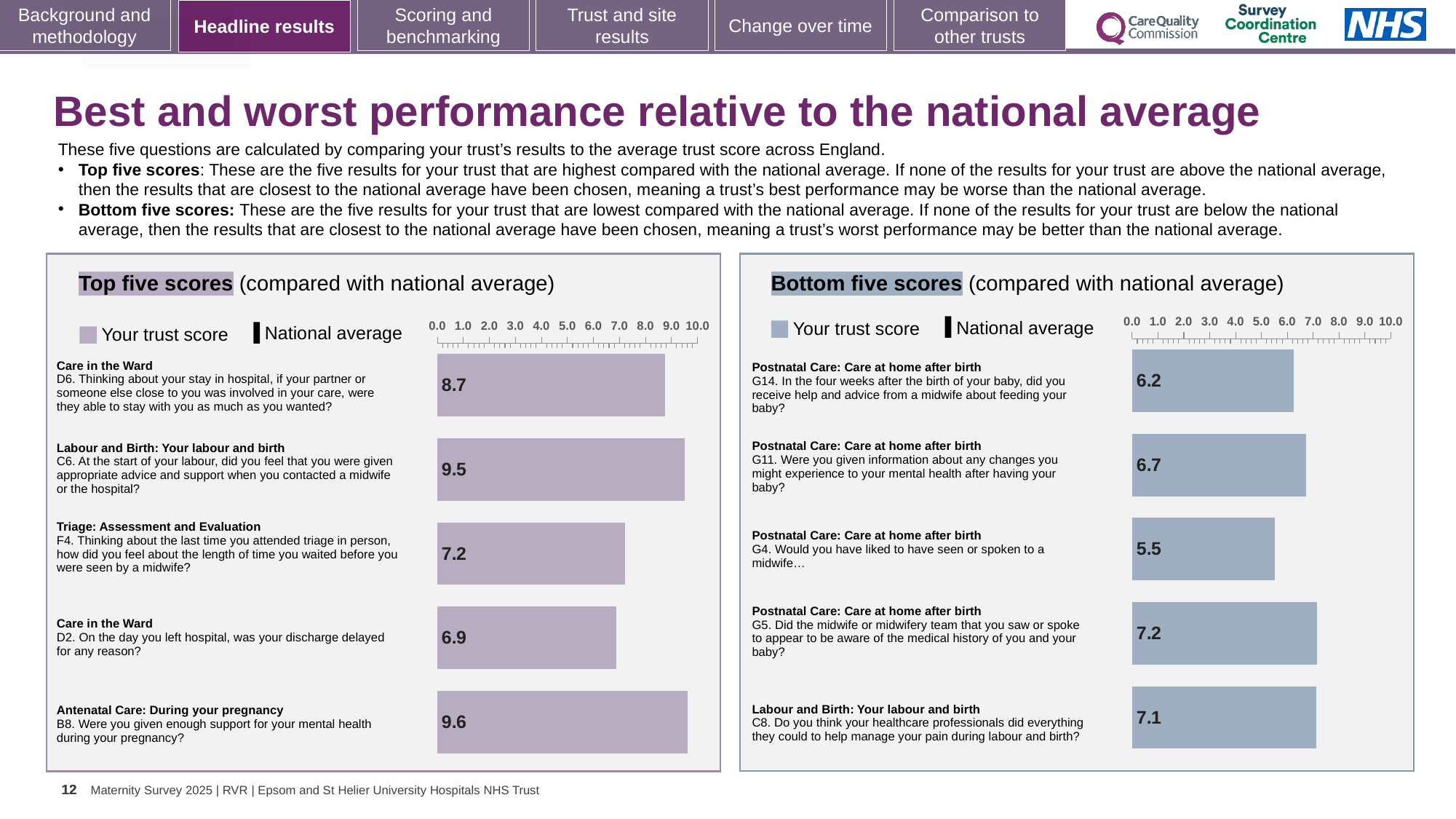
In the Bottom five scores chart, what is the difference between the trust scores for G5 and G14? 1.0 In the Top five scores chart, which question has the lowest trust score? D2 (Care in the Ward) In the Bottom five scores chart, which question has the highest trust score? G5 (Postnatal Care: Care at home after birth) What two entries does the legend of the Top five scores chart list? Your trust score and National average In the Top five scores chart, which has the larger trust score, F4 or D2? F4 In the Bottom five scores chart, which question has the lowest trust score? G4 (Postnatal Care: Care at home after birth) In the Top five scores chart, what is the trust score for D6 (Care in the Ward, partner able to stay with you)? 8.7 In the Top five scores chart, which question has the highest trust score? B8 (Antenatal Care: During your pregnancy) How many bars are shown in the Bottom five scores chart? 5 In the Bottom five scores chart, what is the trust score for G4 (would you have liked to have seen or spoken to a midwife)? 5.5 In the Top five scores chart, what is the difference between the trust scores for C6 and D2? 2.6 What type of chart is the Top five scores chart? Bar chart